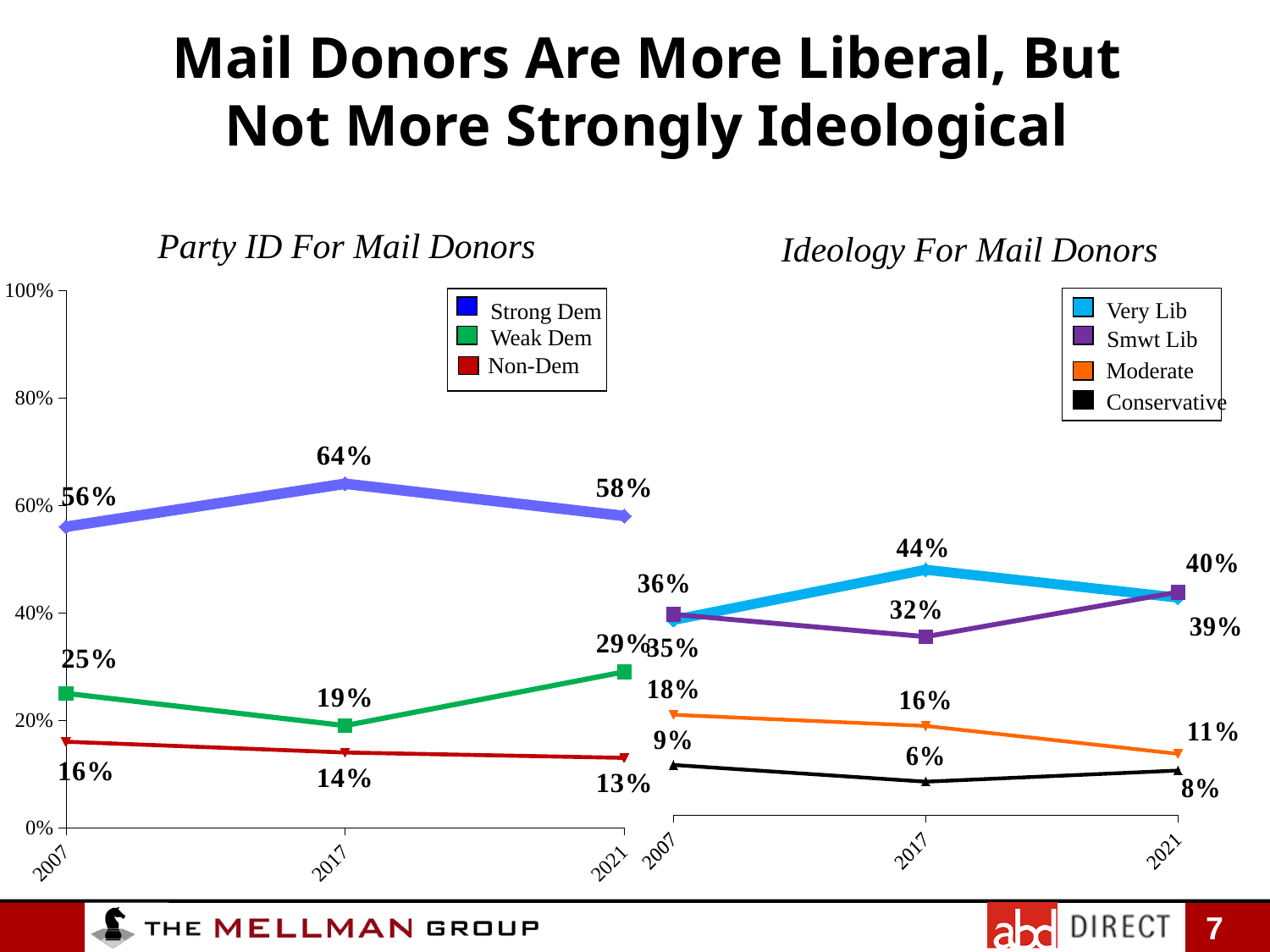
In the "Ideology For Mail Donors" chart, what is the Very Lib value for 2017? 44% In the "Party ID For Mail Donors" chart, what is the Strong Dem value for 2017? 64% In the "Ideology For Mail Donors" chart, what is the Moderate value for 2021? 11% How many series does the legend of the "Party ID For Mail Donors" chart list? 3 What kind of chart is the "Party ID For Mail Donors" chart? Line chart In the "Party ID For Mail Donors" chart, by how many percentage points did Strong Dem rise from 2007 to 2017? 8 percentage points In the "Party ID For Mail Donors" chart, in which year is the Strong Dem value highest? 2017 In the "Party ID For Mail Donors" chart, does the Non-Dem value rise or fall from 2007 to 2021? Fall In the "Party ID For Mail Donors" chart, what is the Non-Dem value for 2007? 16% In the "Party ID For Mail Donors" chart, what is the Weak Dem value for 2021? 29% In the "Ideology For Mail Donors" chart, in which year is the Conservative value lowest? 2017 How many series does the legend of the "Ideology For Mail Donors" chart list? 4